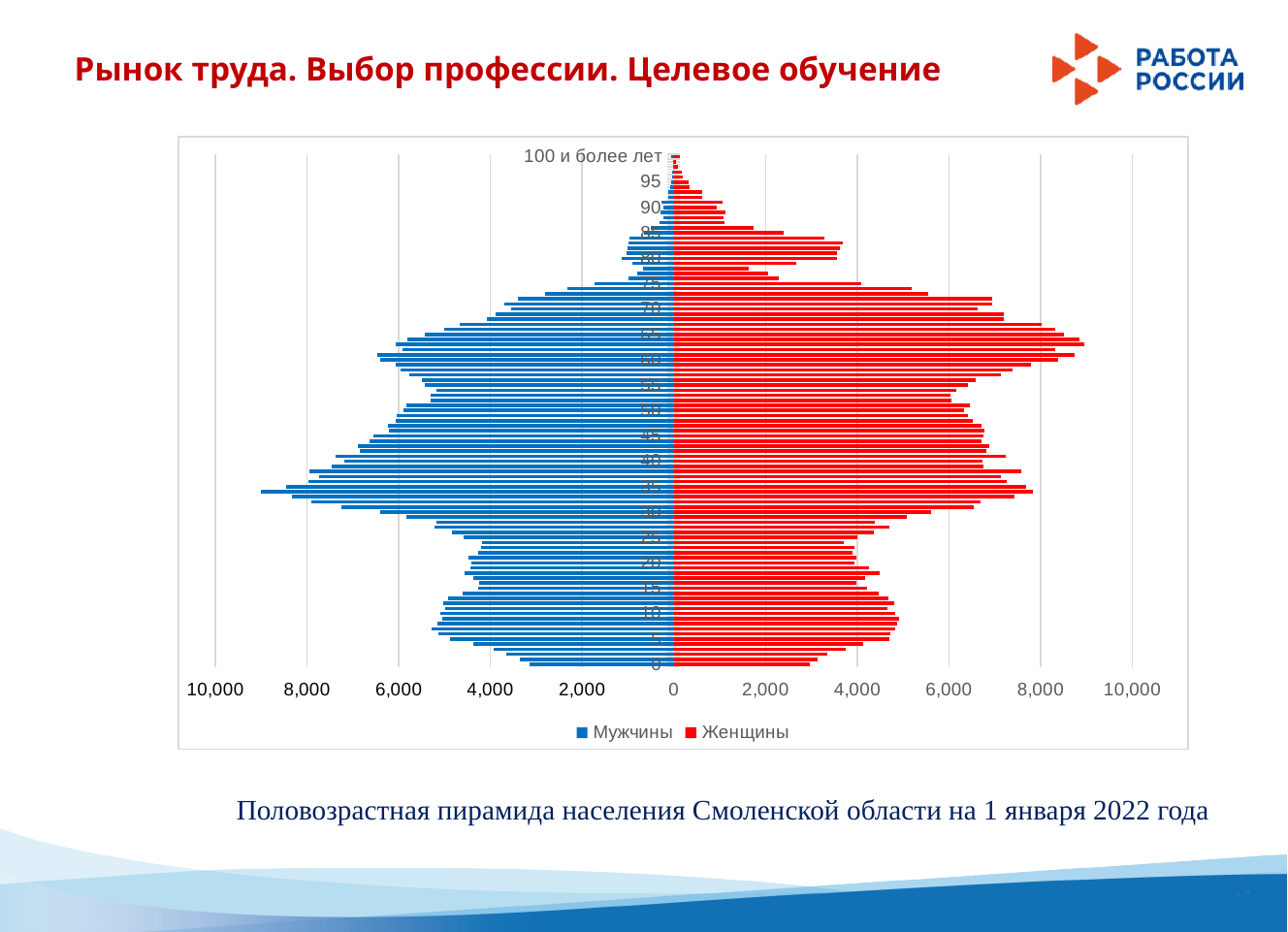
Is the value for Мужчины at age 90 greater or less than 2,000? less Which colour represents the Женщины series? red At which labelled age is the Мужчины bar the longest? 35 What kind of chart is shown on the slide? bar chart Is the value for Женщины at age 65 greater or less than 8,000? greater At age 85, which series has the larger value, Мужчины or Женщины? Женщины What are the two series named in the legend? Мужчины, Женщины At which labelled age is the Женщины bar the longest? 65 Is the value for Женщины at age 85 greater or less than 2,000? greater At age 35, which series has the larger value, Мужчины or Женщины? Мужчины How many series does the legend list? 2